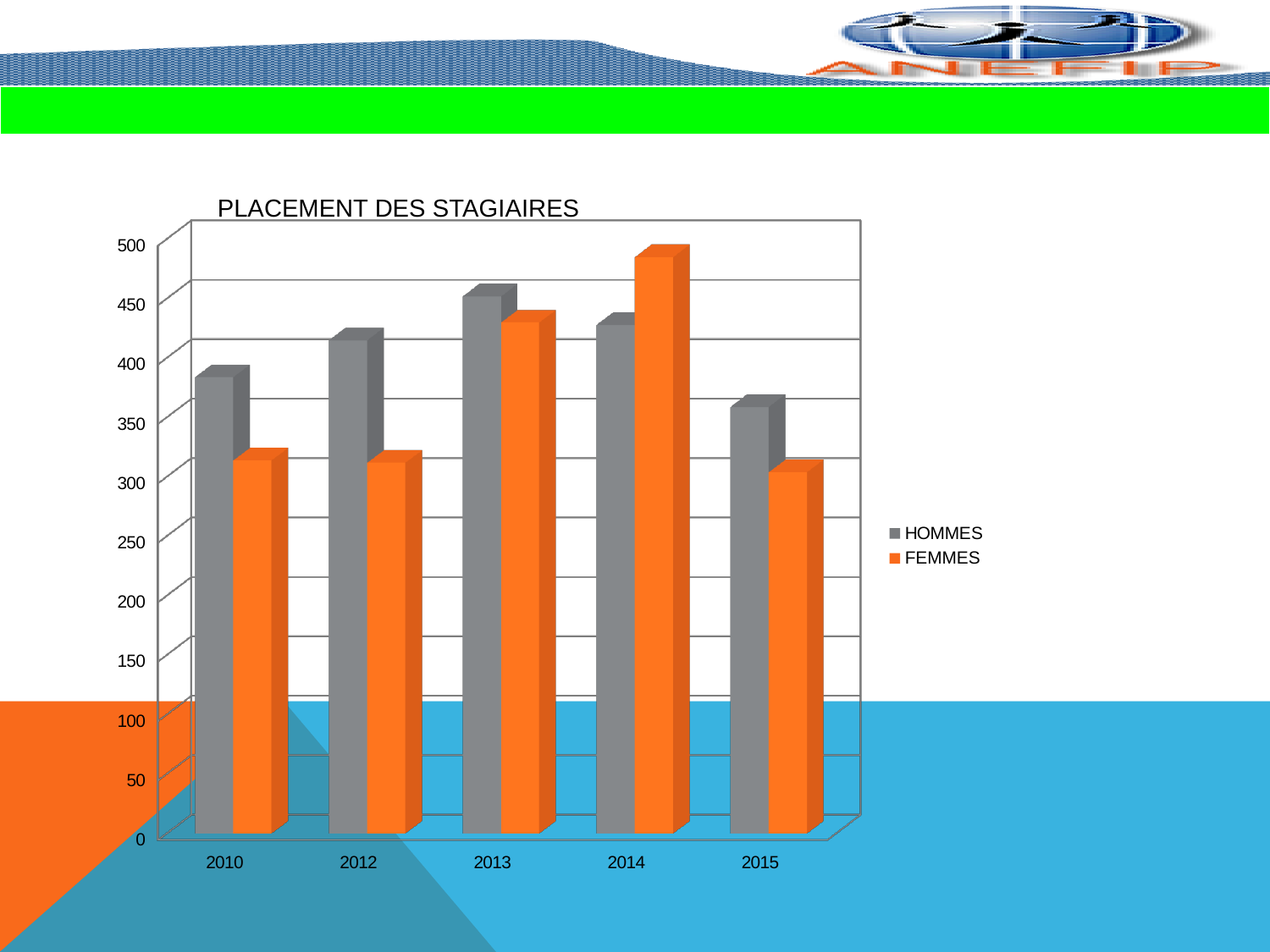
Which colour represents the FEMMES series? orange In which year is the HOMMES value lowest? 2015 How many years are shown on the x axis? 5 In 2010, which series has the larger value, HOMMES or FEMMES? HOMMES How many series does the legend list? 2 In which year is the HOMMES value highest? 2013 In which year is the FEMMES value highest? 2014 In 2014, which series has the larger value, HOMMES or FEMMES? FEMMES Is the HOMMES value for 2013 greater or less than 400? greater What is the title of the chart? PLACEMENT DES STAGIAIRES Is the FEMMES value for 2010 greater or less than 350? less What kind of chart is shown on the slide? bar chart